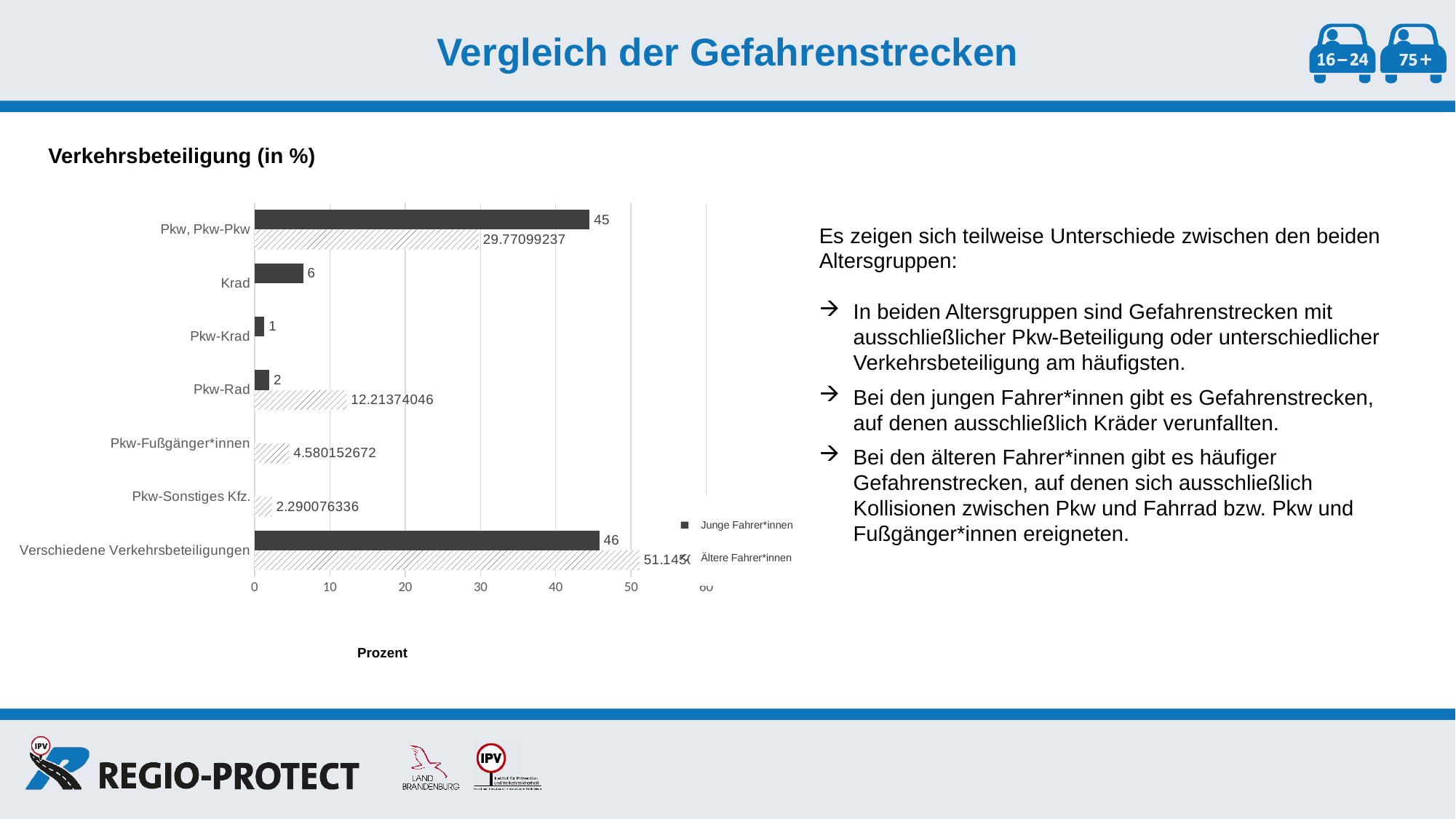
What is the value for Ältere Fahrer*innen in the category Pkw-Rad? 12.21374046 What is the value for Ältere Fahrer*innen in the category Pkw-Fußgänger*innen? 4.580152672 How many categories are shown on the chart? 7 Which category has the lowest value for Junge Fahrer*innen? Pkw-Krad What is the value for Junge Fahrer*innen in the category Pkw, Pkw-Pkw? 45 What is the value for Junge Fahrer*innen in the category Krad? 6 What is the value for Ältere Fahrer*innen in the category Pkw, Pkw-Pkw? 29.77099237 Is the value for Ältere Fahrer*innen in the category Verschiedene Verkehrsbeteiligungen greater or less than 50? greater What kind of chart is shown on the slide? bar chart In the category Pkw-Rad, which series has the larger value, Junge Fahrer*innen or Ältere Fahrer*innen? Ältere Fahrer*innen What is the difference between the Junge Fahrer*innen and Ältere Fahrer*innen values for Pkw, Pkw-Pkw? 15.22900763 How many series does the legend list? 2